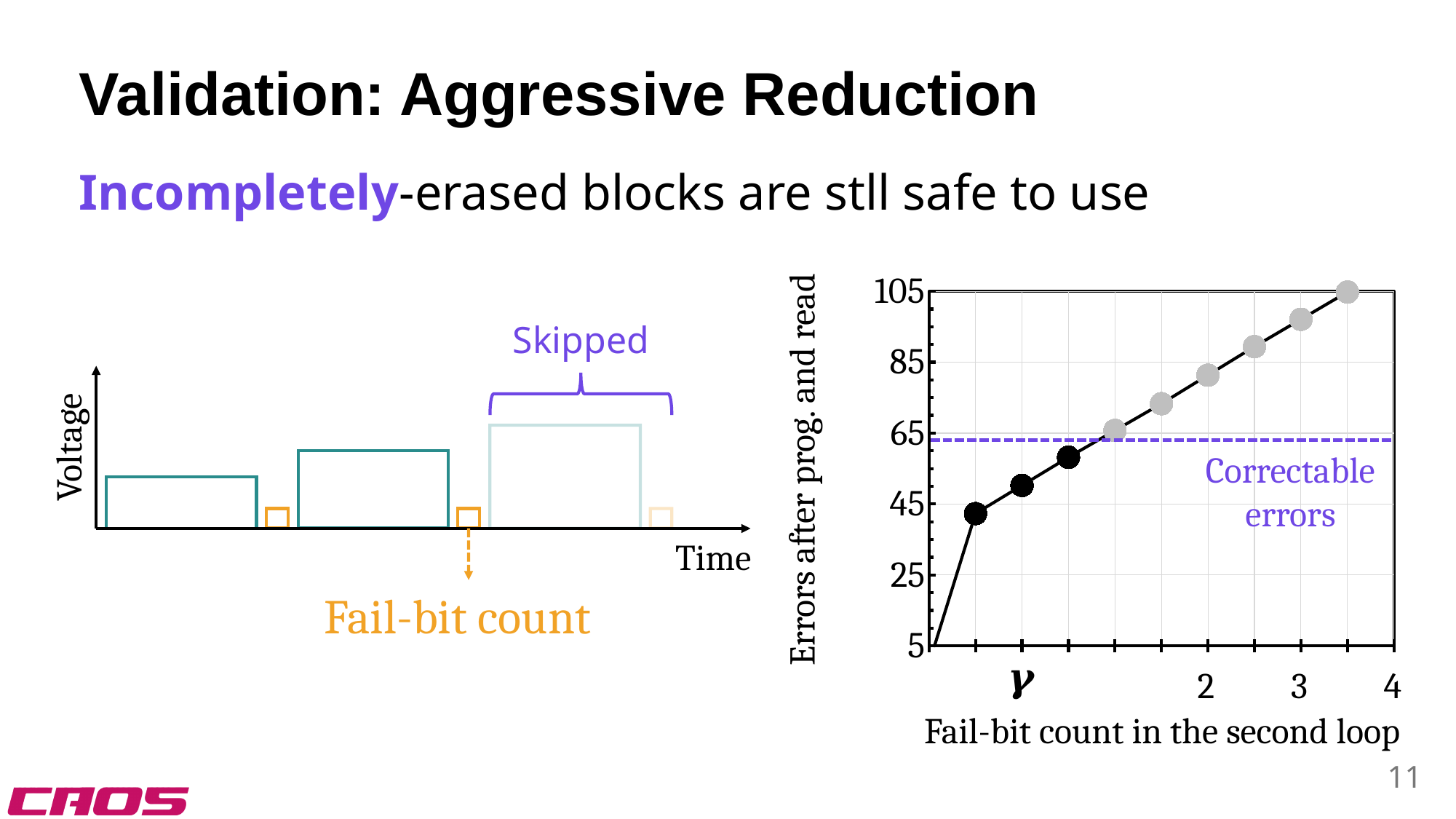
In the right-hand chart, is the value at fail-bit count 2 greater or less than 85? less In the right-hand chart, is the value at fail-bit count 3 greater or less than 85? greater In the right-hand chart, is the value at fail-bit count γ greater or less than 45? greater How many grey data points are plotted in the right-hand chart? 6 What kind of chart is shown on the right of the slide? line chart What does the dashed horizontal line in the right-hand chart represent? Correctable errors In the right-hand chart, do the errors rise or fall as the fail-bit count in the second loop increases? rise How many data points are plotted in the right-hand chart? 9 In the right-hand chart, which has more errors: the point at fail-bit count 2 or the point at fail-bit count 3? fail-bit count 3 How many black (filled dark) data points are plotted in the right-hand chart? 3 What is the label of the y-axis in the right-hand chart? Errors after prog. and read